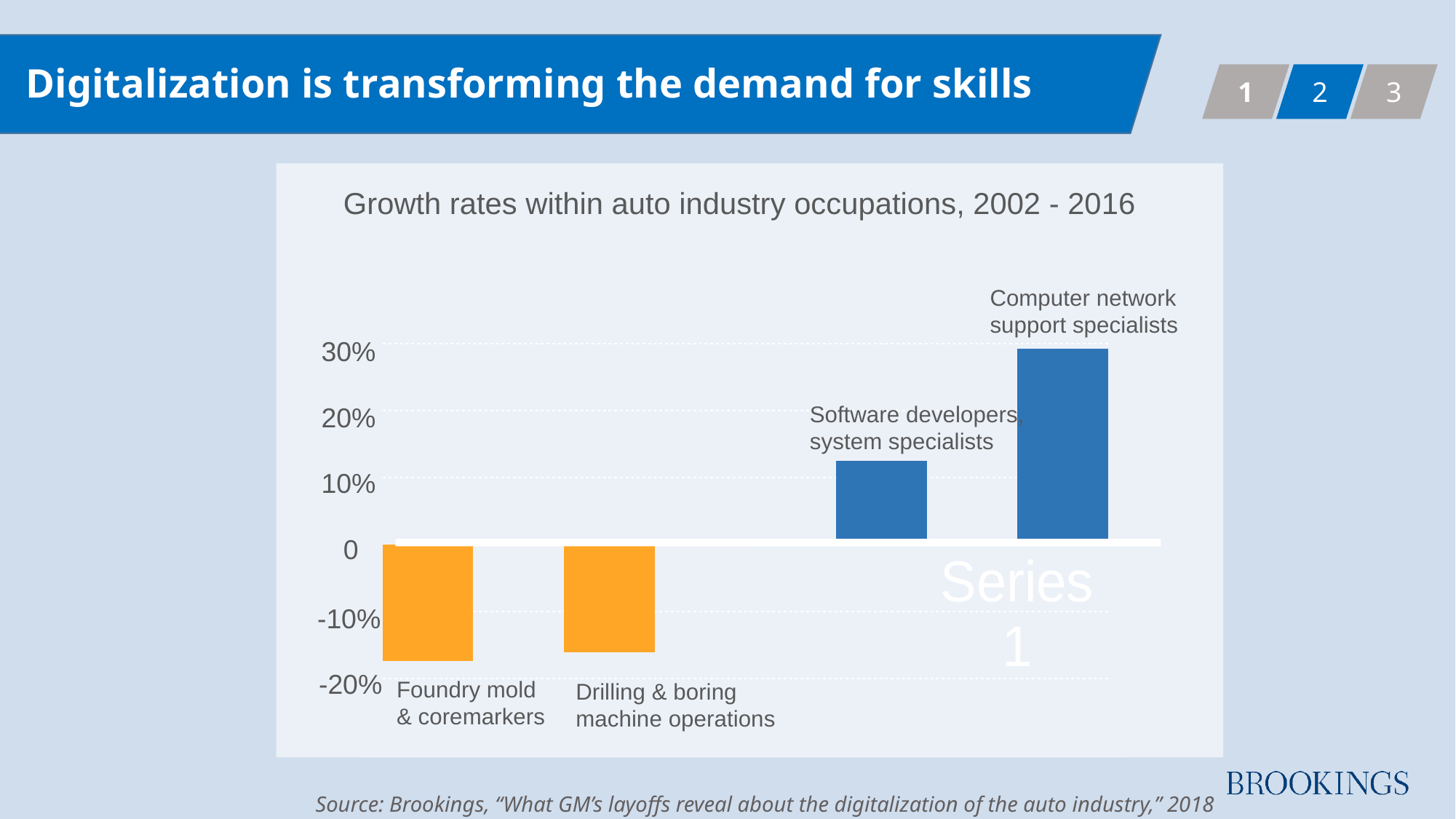
Which has the larger growth rate: Computer network support specialists or Software developers, system specialists? Computer network support specialists What colour are the bars for the occupations with negative growth rates? Orange Which occupation has the highest growth rate in the chart? Computer network support specialists Is the growth rate for Software developers, system specialists greater or less than 10%? greater How many occupations (bars) are plotted in the chart? 4 Is the growth rate for Foundry mold & coremakers greater or less than -10%? less What kind of chart is shown on the slide? Bar chart Is the growth rate for Computer network support specialists greater or less than 20%? greater What is the title of the chart? Growth rates within auto industry occupations, 2002 - 2016 Do the growth rates rise or fall moving from left to right across the bars? Rise Which has the larger growth rate: Software developers, system specialists or Drilling & boring machine operations? Software developers, system specialists